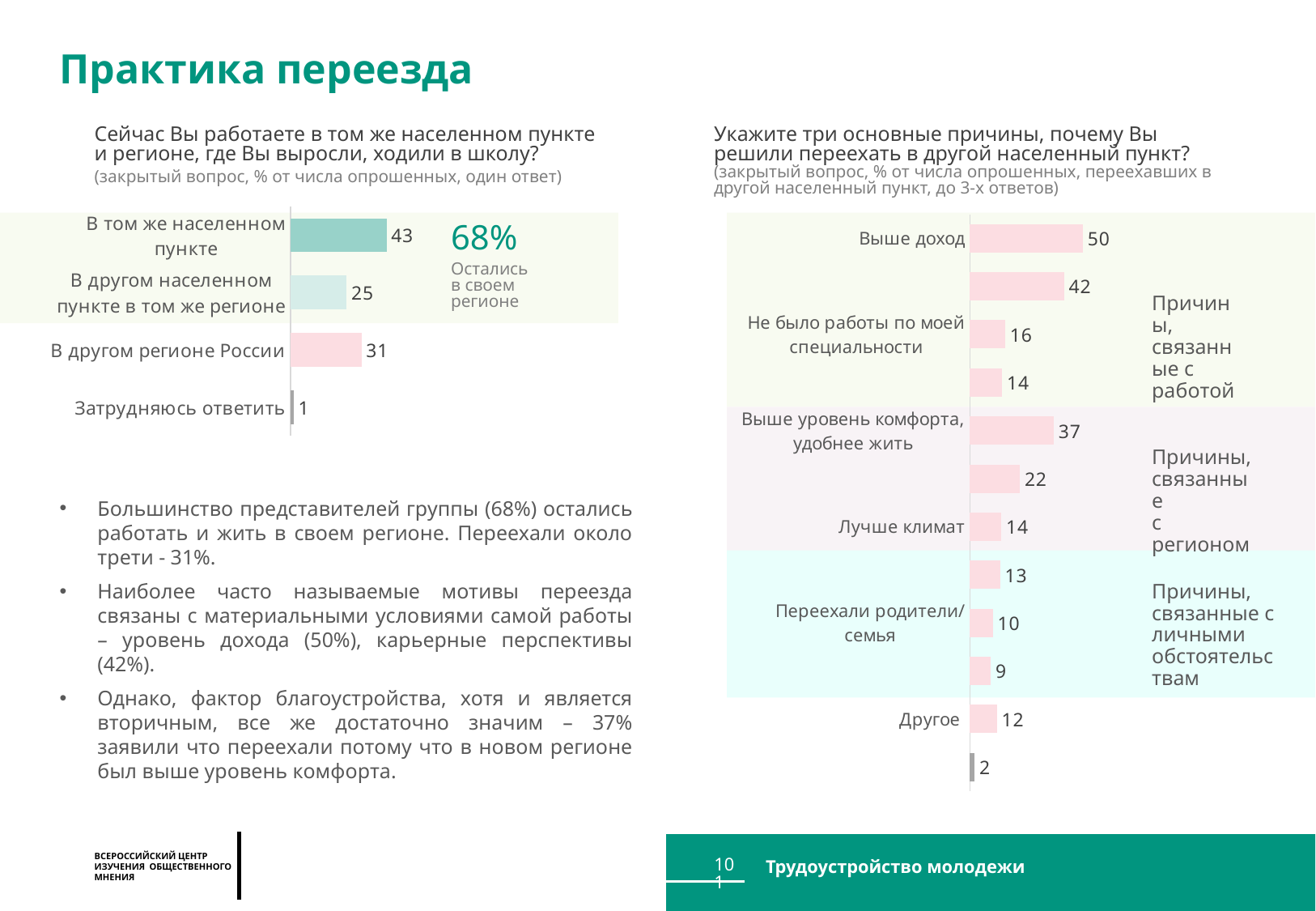
In the left chart, which category has the highest value? В том же населенном пункте In the right chart (Укажите три основные причины...), what is the value for «Выше доход»? 50 In the left chart, which category has the lowest value? Затрудняюсь ответить In the left chart, what is the difference between «В том же населенном пункте» and «В другом населенном пункте в том же регионе»? 18 In the right chart, which reason has the highest value? Выше доход What type of chart is the left chart? Bar chart In the right chart, which is larger: «Лучше климат» or «Другое»? Лучше климат In the right chart, what is the difference between «Выше доход» and «Выше уровень комфорта, удобнее жить»? 13 In the left chart, what is the value for «В другом регионе России»? 31 How many categories are shown in the left chart? 4 In the right chart, what is the value for «Выше уровень комфорта, удобнее жить»? 37 In the left chart (Сейчас Вы работаете в том же населенном пункте...), what is the value for «В том же населенном пункте»? 43